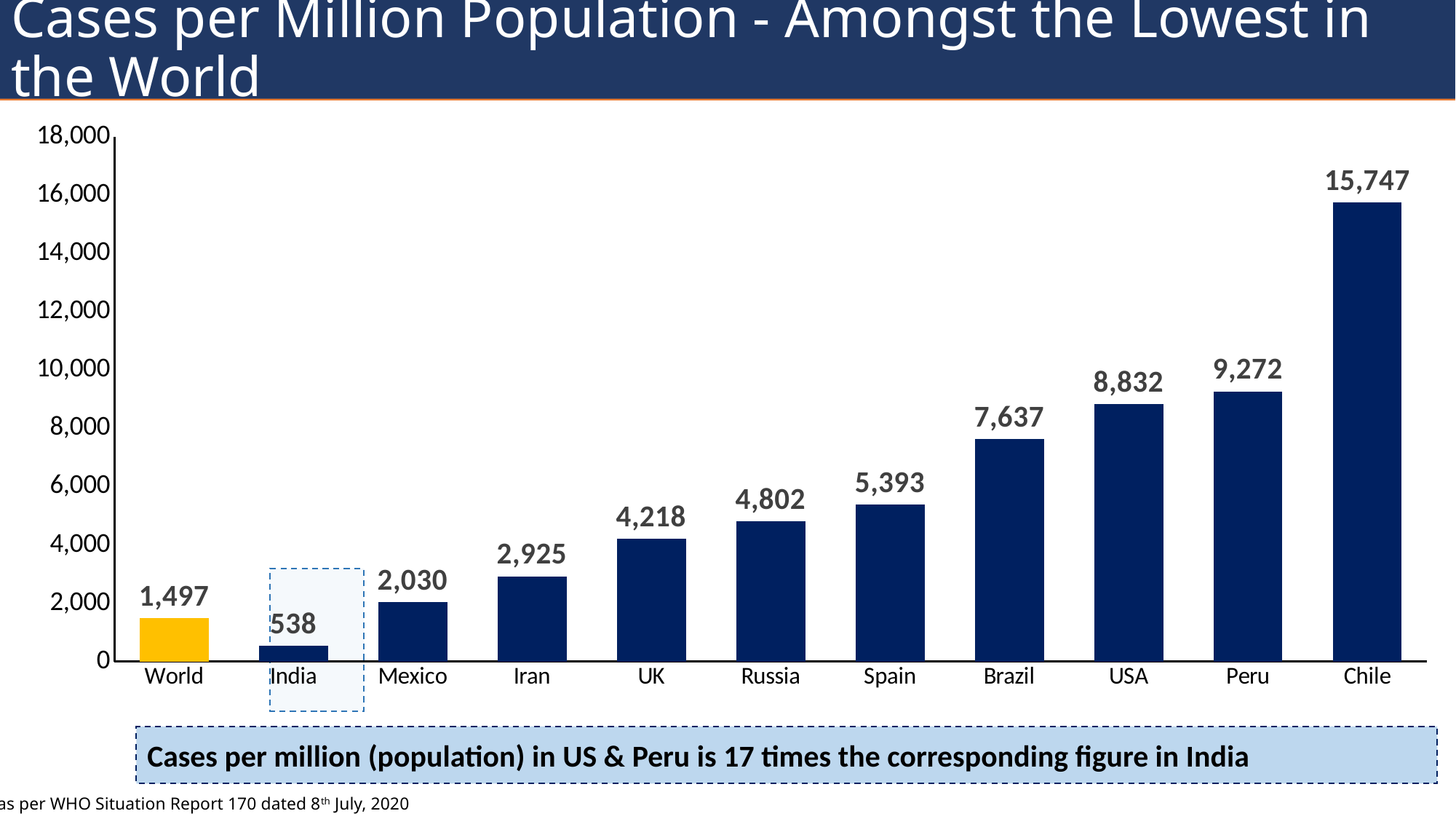
What is the value for the World? 1,497 Which is larger, the value for Spain or the value for Russia? Spain What is the value for Chile? 15,747 Is the value for Brazil greater or less than 8,000? less Which bar is coloured differently (yellow) from the others? World What is the difference between the values for Peru and USA? 440 Which category has the lowest value? India Do the values rise or fall from India to Chile along the x axis? rise What kind of chart is shown on the slide? bar chart What is the value for India? 538 How many categories are shown on the x axis? 11 Which category has the highest value? Chile